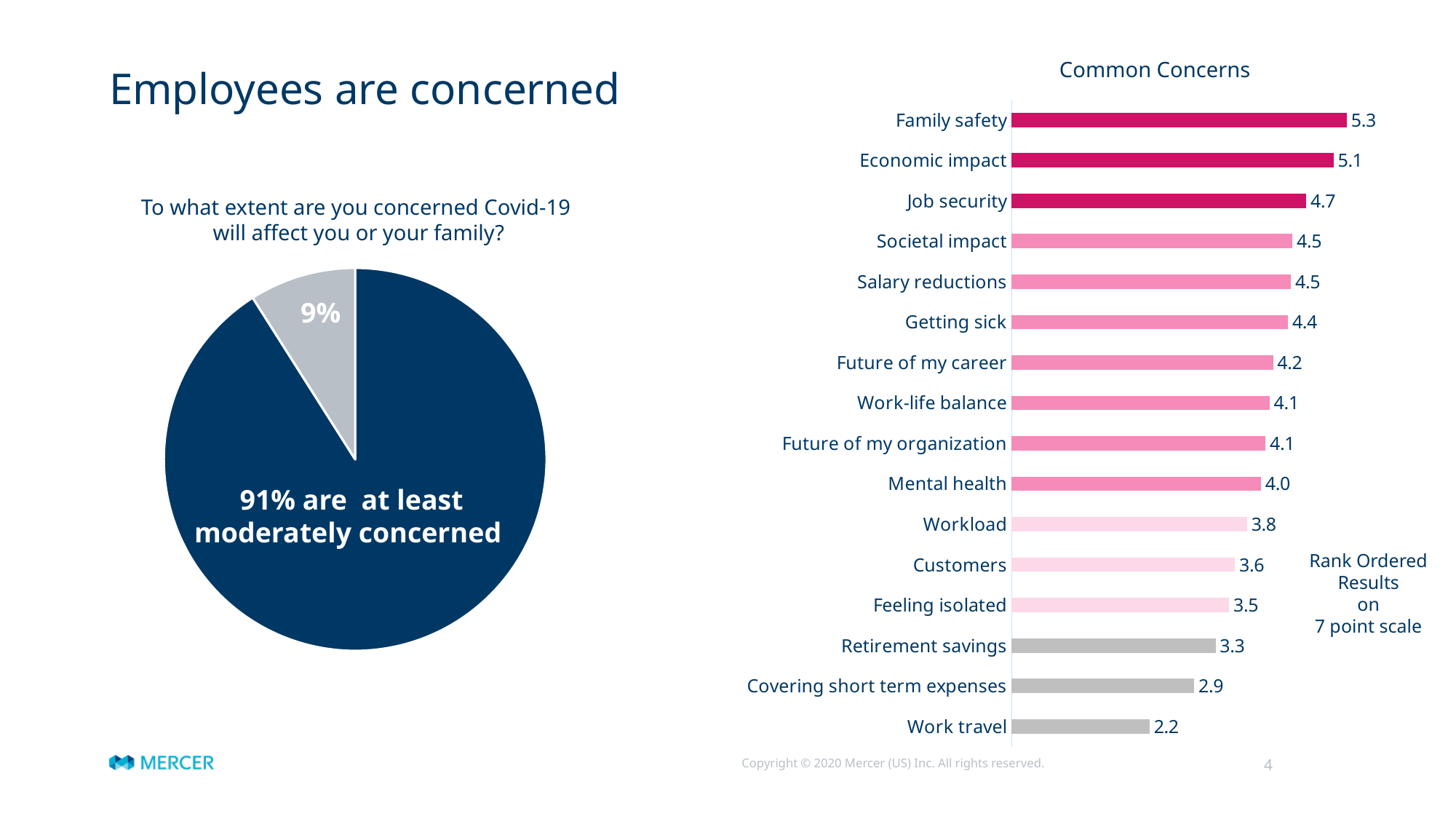
In the Common Concerns chart, what is the difference between the values for Economic impact and Job security? 0.4 In the Common Concerns chart, what is the value for Mental health? 4.0 In the Common Concerns chart, what is the value for Covering short term expenses? 2.9 In the Common Concerns chart, which concern has the lowest value? Work travel In the pie chart on the left, what percentage are at least moderately concerned? 91% In the Common Concerns chart, which concern has the highest value? Family safety In the Common Concerns chart, what is the value for Family safety? 5.3 What kind of chart is the chart on the left of the slide? Pie chart In the pie chart on the left, what share of the pie is the grey slice? 9% How many concerns are listed in the Common Concerns chart? 16 In the Common Concerns chart, which is larger, the value for Workload or the value for Retirement savings? Workload What kind of chart is the Common Concerns chart? Bar chart